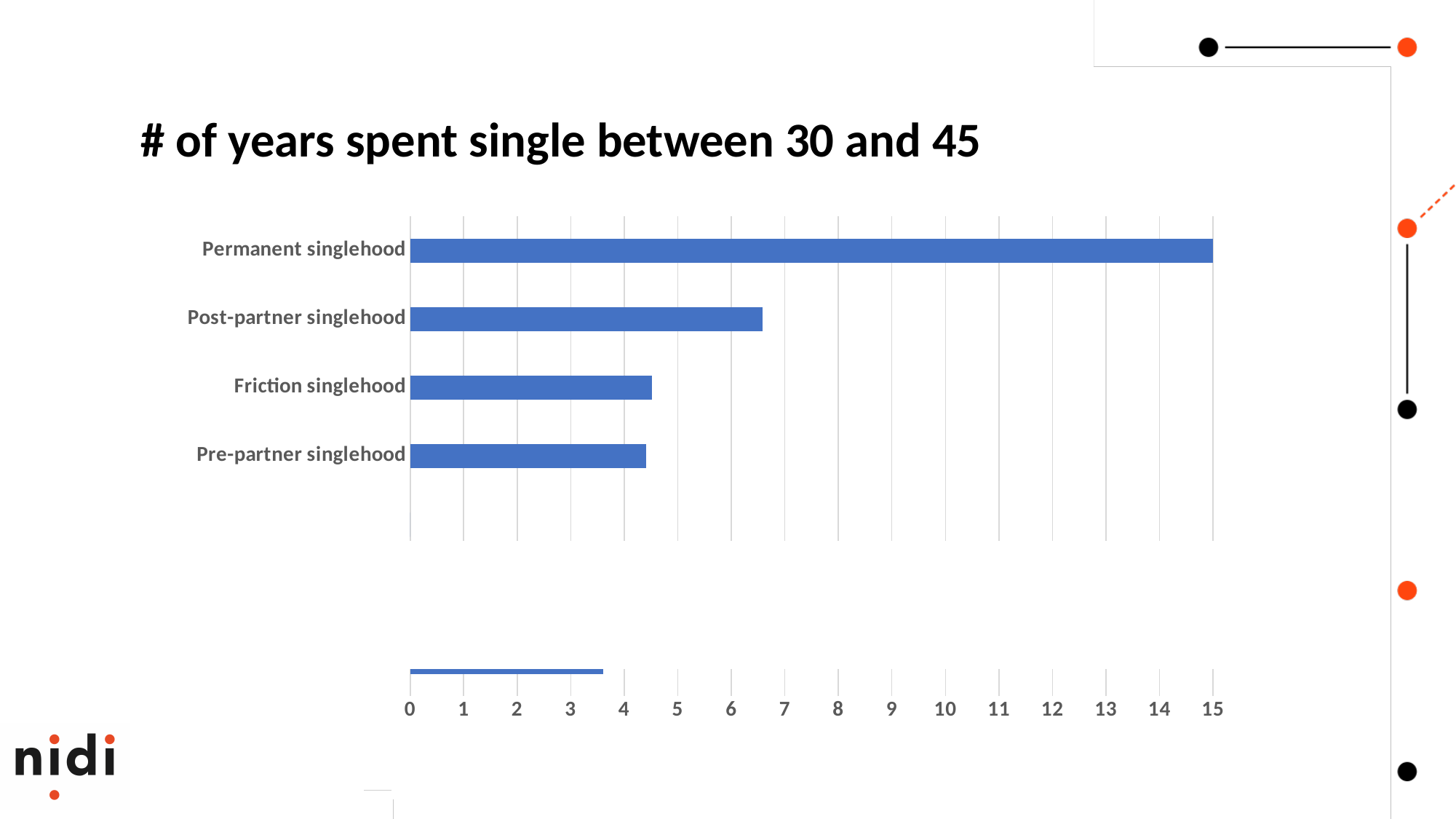
Is the value for Friction singlehood greater or less than 5? less What kind of chart is shown on the slide? bar chart Which is larger, the value for Permanent singlehood or Post-partner singlehood? Permanent singlehood Is the value for Friction singlehood greater or less than 4? greater Is the value for Pre-partner singlehood greater or less than 4? greater What is the highest value shown on the horizontal axis? 15 What is the title of the chart? # of years spent single between 30 and 45 How many years spent single are shown for Permanent singlehood? 15 Which category has the highest number of years spent single? Permanent singlehood Which is larger, the value for Post-partner singlehood or Friction singlehood? Post-partner singlehood